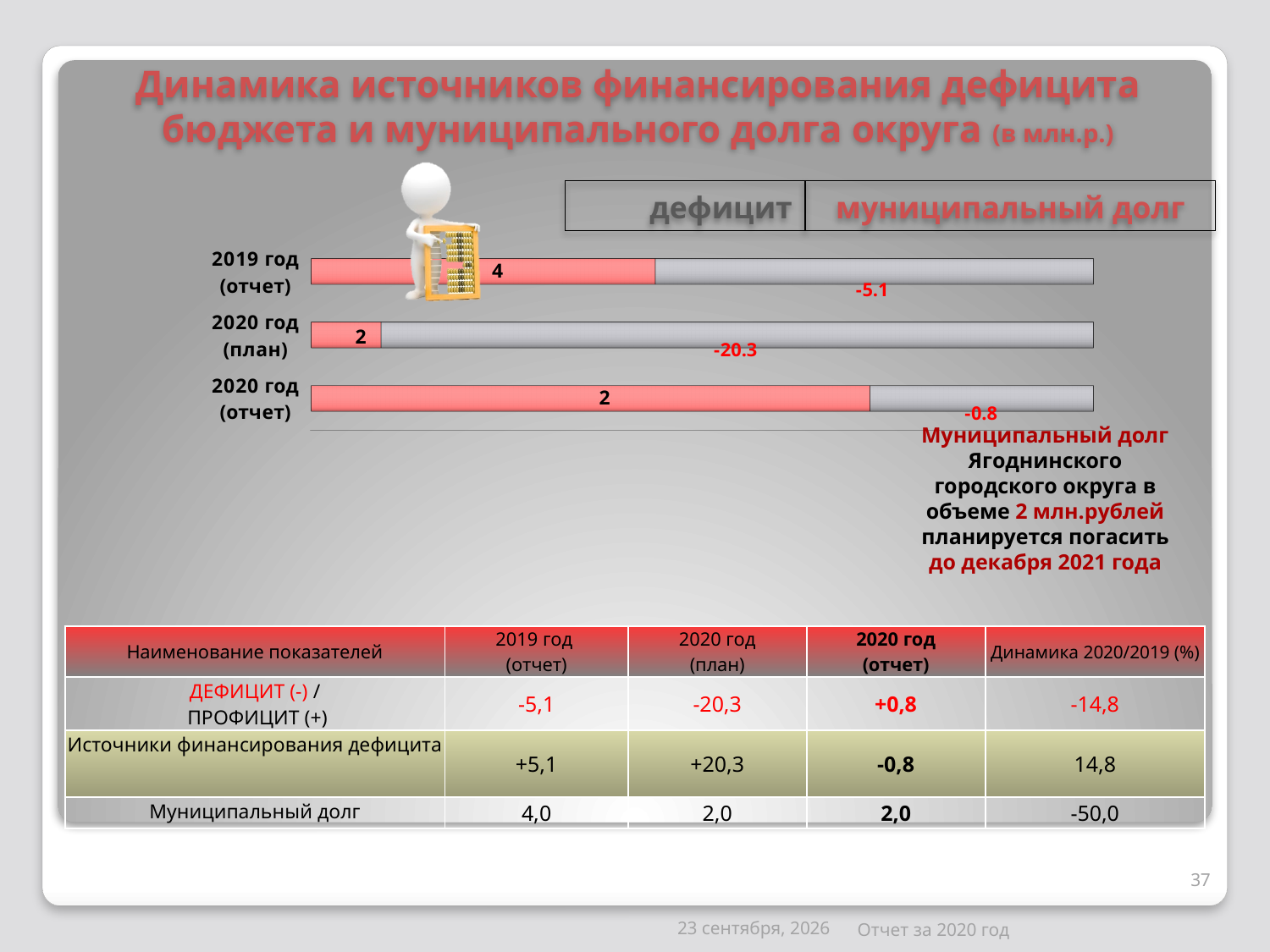
Which category has the highest value of муниципальный долг? 2019 год (отчет) Which category has the lowest value of дефицит? 2020 год (план) What is the value of дефицит for 2020 год (отчет)? -0.8 Which is larger: дефицит for 2019 год (отчет) or for 2020 год (план)? 2019 год (отчет) What is the difference between муниципальный долг in 2019 год (отчет) and 2020 год (план)? 2 What is the value of муниципальный долг for 2020 год (отчет)? 2 What are the two series named in the chart legend? дефицит and муниципальный долг What type of chart is shown on the slide? bar chart What is the value of муниципальный долг for 2019 год (отчет)? 4 How many series does the chart legend list? 2 What is the value of дефицит for 2020 год (план)? -20.3 How many categories (years) are plotted on the chart? 3